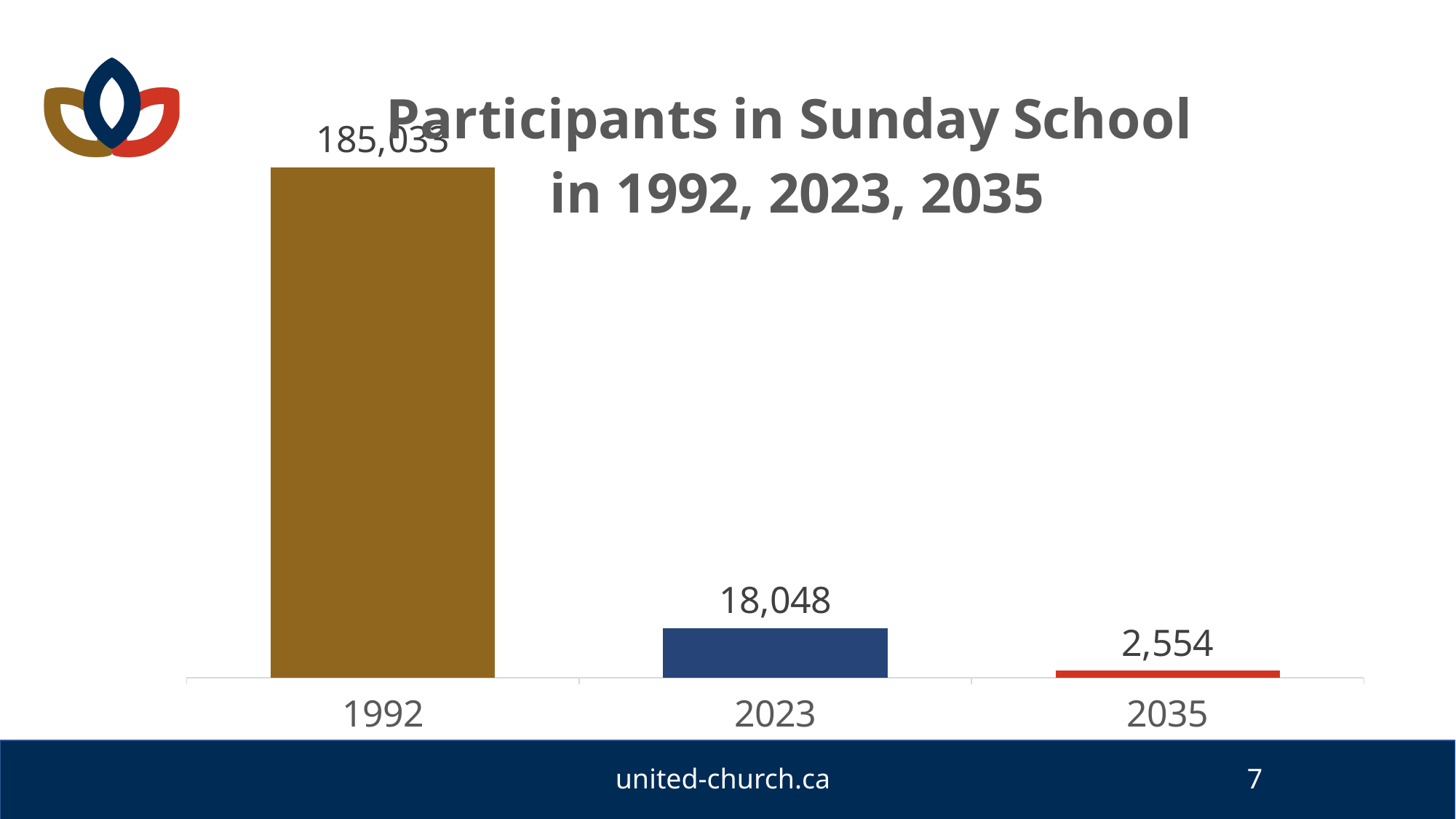
What is the difference between the values for 2023 and 2035? 15,494 What kind of chart is shown on the slide? bar chart Which is larger, the value for 2023 or the value for 2035? 2023 What is the value for 2023? 18,048 Which is larger, the value for 1992 or the value for 2023? 1992 What is the value for 2035? 2,554 What is the title of the chart? Participants in Sunday School in 1992, 2023, 2035 How many years are shown on the chart? 3 Which year has the lowest number of participants? 2035 What colour is the bar for 2035? red Do the values rise or fall from 1992 to 2035? fall Which year has the highest number of participants? 1992